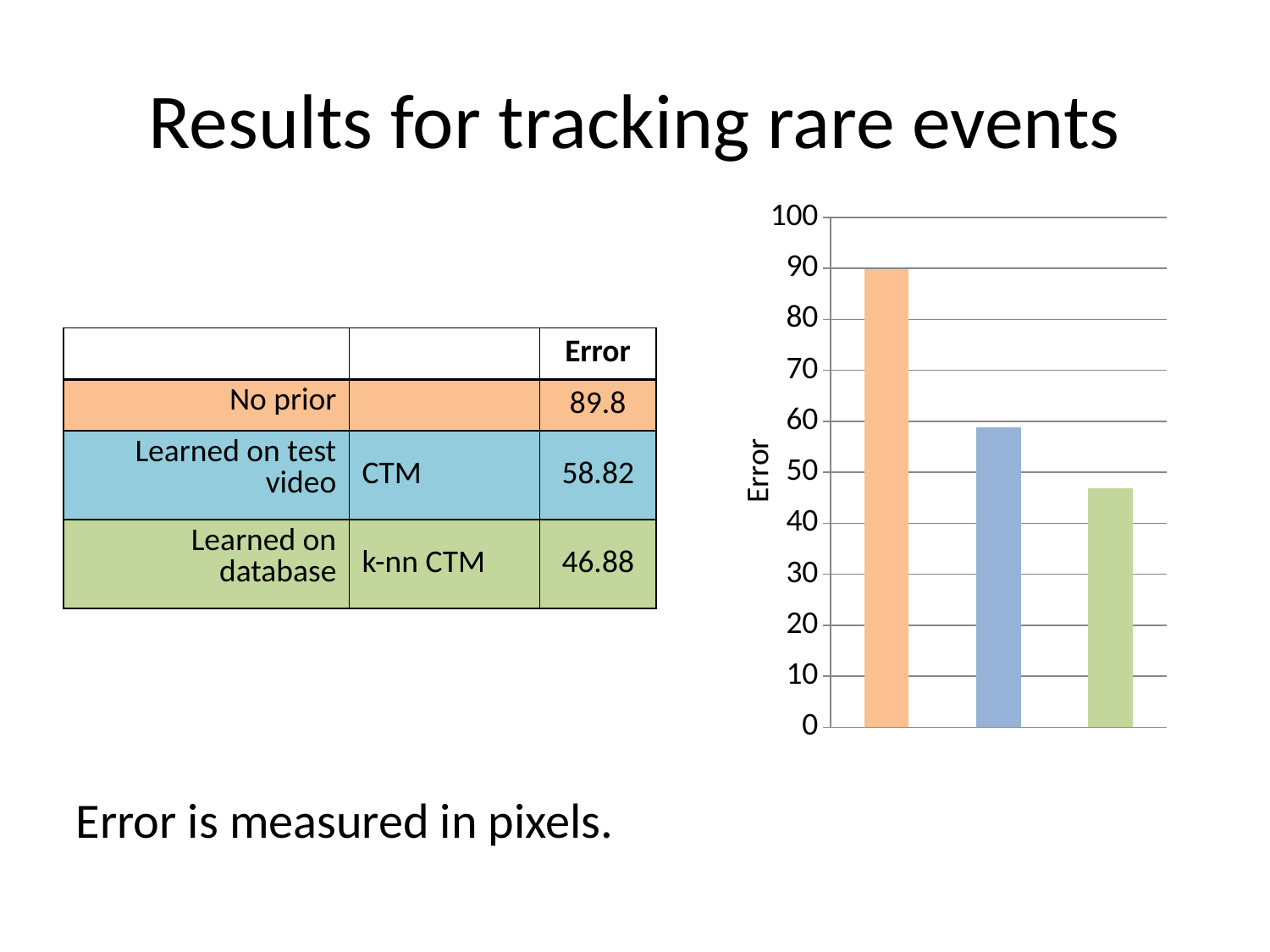
How many bars does the chart show? 3 Which is larger, the value of the blue bar or the value of the green bar? blue bar Which bar is the tallest in the chart: the orange, blue or green one? orange Is the value of the green bar greater or less than 50? less What is the label on the vertical axis of the chart? Error According to the slide, what is the error for the 'No prior' condition, shown by the orange bar? 89.8 Is the value of the blue bar greater or less than 60? less What kind of chart is shown on the slide? bar chart Which bar is the shortest in the chart: the orange, blue or green one? green Is the value of the orange bar greater or less than 80? greater According to the slide, what is the error for 'Learned on database' (k-nn CTM), shown by the green bar? 46.88 Do the bar values rise or fall from left to right across the chart? fall